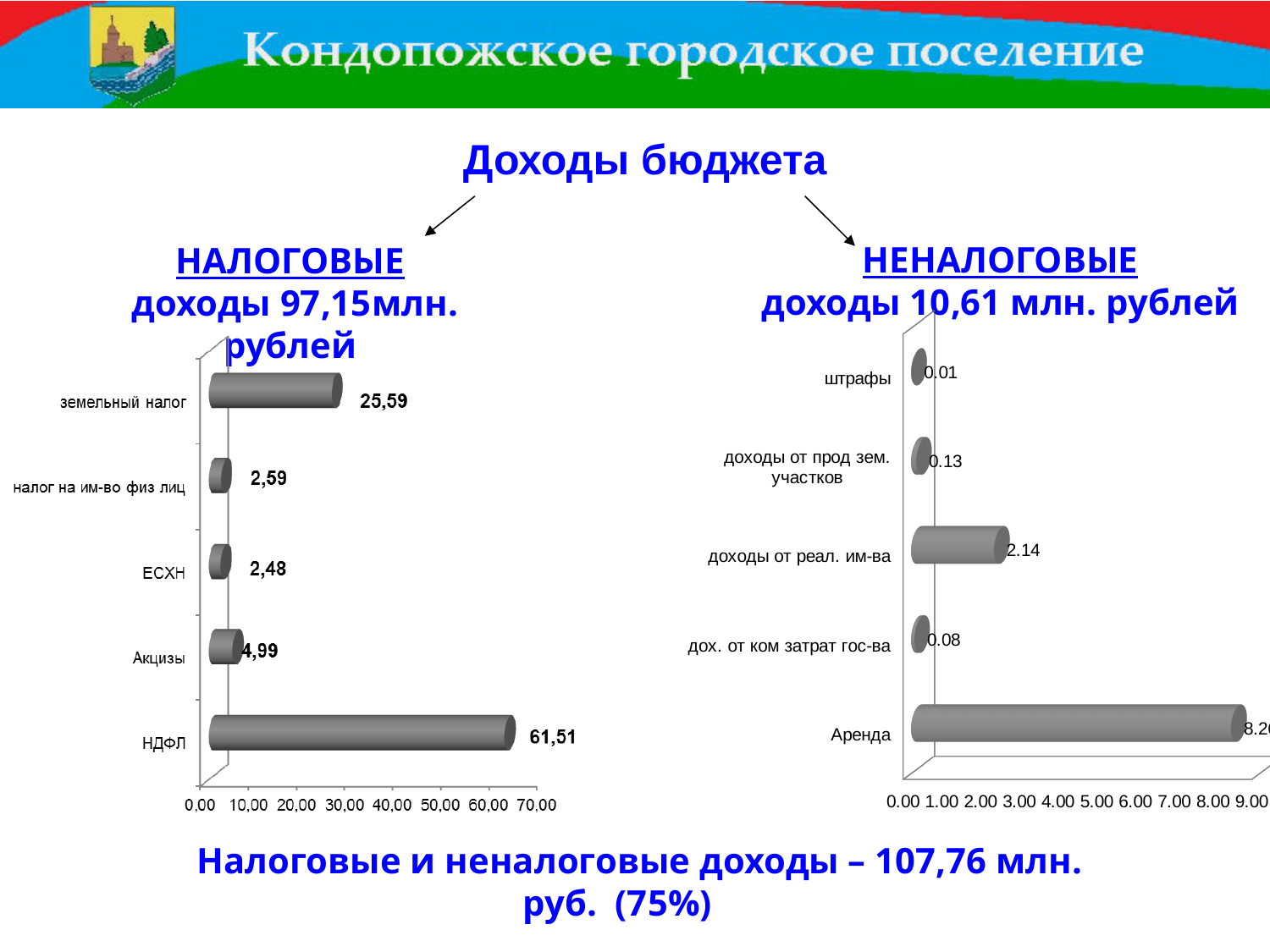
On the left chart (НАЛОГОВЫЕ доходы), what is the value for земельный налог? 25,59 On the right chart (НЕНАЛОГОВЫЕ доходы), what is the difference between доходы от прод зем. участков and дох. от ком затрат гос-ва? 0.05 What kind of chart is the left chart (НАЛОГОВЫЕ доходы)? Bar chart On the left chart (НАЛОГОВЫЕ доходы), what is the difference between НДФЛ and земельный налог? 35,92 On the left chart (НАЛОГОВЫЕ доходы), which is larger: Акцизы or налог на им-во физ лиц? Акцизы On the left chart (НАЛОГОВЫЕ доходы), how many categories are shown? 5 On the left chart (НАЛОГОВЫЕ доходы), what is the value for НДФЛ? 61,51 On the left chart (НАЛОГОВЫЕ доходы), which category has the lowest value? ЕСХН On the right chart (НЕНАЛОГОВЫЕ доходы), is the value for Аренда greater or less than 8.00? greater On the right chart (НЕНАЛОГОВЫЕ доходы), what is the value for доходы от реал. им-ва? 2.14 On the right chart (НЕНАЛОГОВЫЕ доходы), which category has the highest value? Аренда On the right chart (НЕНАЛОГОВЫЕ доходы), which category has the lowest value? штрафы